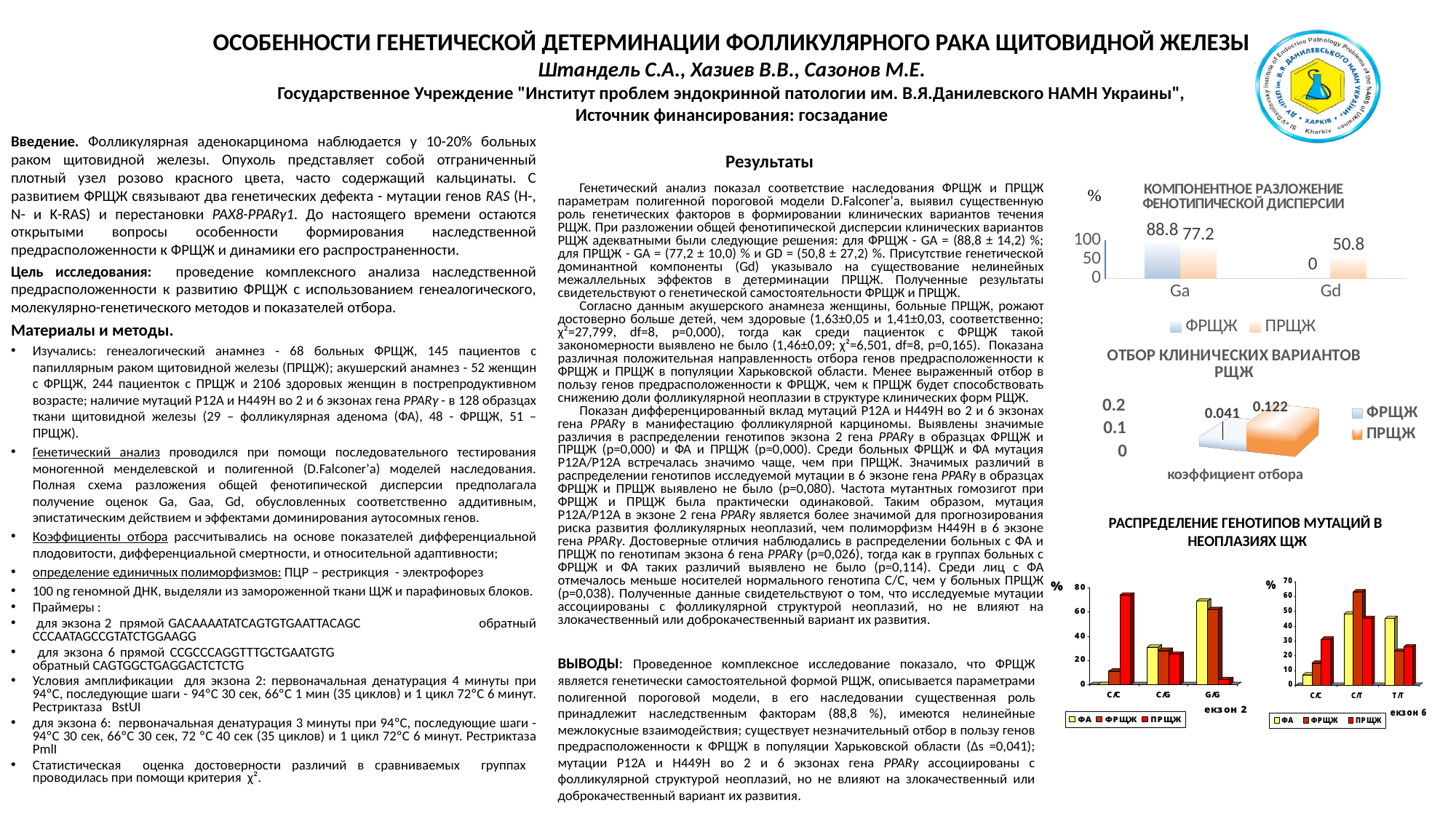
In the chart titled 'КОМПОНЕНТНОЕ РАЗЛОЖЕНИЕ ФЕНОТИПИЧЕСКОЙ ДИСПЕРСИИ', what is the value for ФРЩЖ at Ga? 88.8 In the экзон 2 chart under 'РАСПРЕДЕЛЕНИЕ ГЕНОТИПОВ МУТАЦИЙ В НЕОПЛАЗИЯХ ЩЖ', is the value for ПРЩЖ at C/C greater or less than 60? greater In the chart titled 'ОТБОР КЛИНИЧЕСКИХ ВАРИАНТОВ РЩЖ', what is the коэффициент отбора for ПРЩЖ? 0.122 In the chart titled 'ОТБОР КЛИНИЧЕСКИХ ВАРИАНТОВ РЩЖ', what is the difference between the ПРЩЖ and ФРЩЖ values? 0.081 In the экзон 6 chart under 'РАСПРЕДЕЛЕНИЕ ГЕНОТИПОВ МУТАЦИЙ В НЕОПЛАЗИЯХ ЩЖ', how many genotype categories are shown on the x axis? 3 In the chart titled 'ОТБОР КЛИНИЧЕСКИХ ВАРИАНТОВ РЩЖ', what is the коэффициент отбора for ФРЩЖ? 0.041 In the chart titled 'КОМПОНЕНТНОЕ РАЗЛОЖЕНИЕ ФЕНОТИПИЧЕСКОЙ ДИСПЕРСИИ', what is the value for ПРЩЖ at Gd? 50.8 In the chart titled 'КОМПОНЕНТНОЕ РАЗЛОЖЕНИЕ ФЕНОТИПИЧЕСКОЙ ДИСПЕРСИИ', what unit is shown on the vertical axis? % In the chart titled 'ОТБОР КЛИНИЧЕСКИХ ВАРИАНТОВ РЩЖ', what kind of chart is it? bar chart In the chart titled 'КОМПОНЕНТНОЕ РАЗЛОЖЕНИЕ ФЕНОТИПИЧЕСКОЙ ДИСПЕРСИИ', what is the difference between the ФРЩЖ and ПРЩЖ values at Ga? 11.6 In the chart titled 'КОМПОНЕНТНОЕ РАЗЛОЖЕНИЕ ФЕНОТИПИЧЕСКОЙ ДИСПЕРСИИ', how many series does the legend list? 2 In the chart titled 'КОМПОНЕНТНОЕ РАЗЛОЖЕНИЕ ФЕНОТИПИЧЕСКОЙ ДИСПЕРСИИ', which series has the larger value at Gd, ФРЩЖ or ПРЩЖ? ПРЩЖ